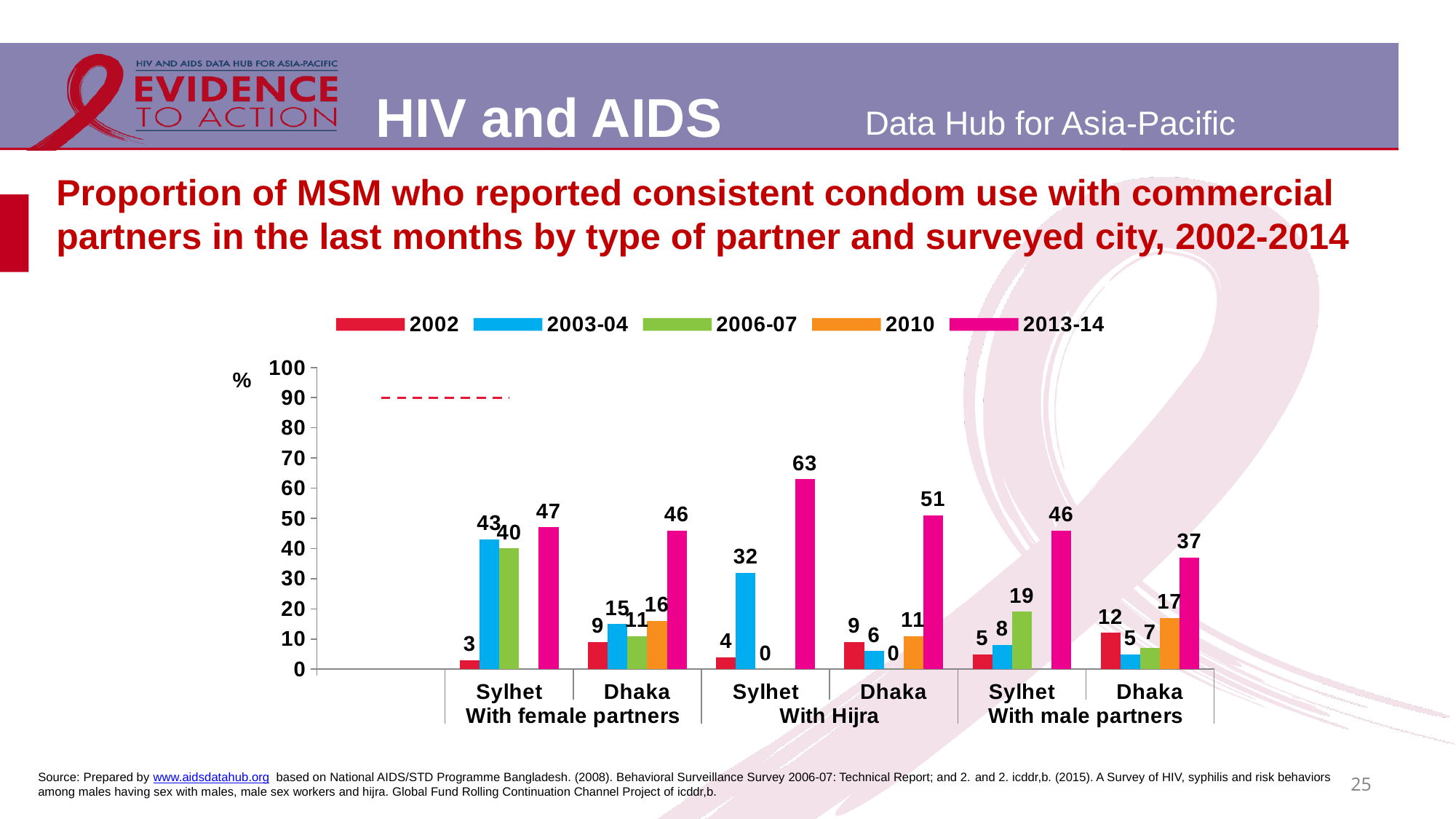
How many series does the legend list? 5 Is the 2013-14 value for Dhaka with male partners greater or less than 40? less Which city and partner type has the highest 2013-14 value? Sylhet, With Hijra Which is larger for Sylhet with male partners: the 2006-07 value or the 2003-04 value? 2006-07 What is the difference between the 2013-14 and 2002 values for Dhaka with female partners? 37 Which city and partner type has the lowest 2002 value? Sylhet, With female partners What is the 2010 value for Dhaka with male partners? 17 What type of chart is shown on the slide? bar chart What is the 2003-04 value for Sylhet with female partners? 43 Which series is shown in pink in the legend? 2013-14 What is the 2013-14 value for Sylhet with Hijra? 63 What is the 2006-07 value for Dhaka with Hijra? 0